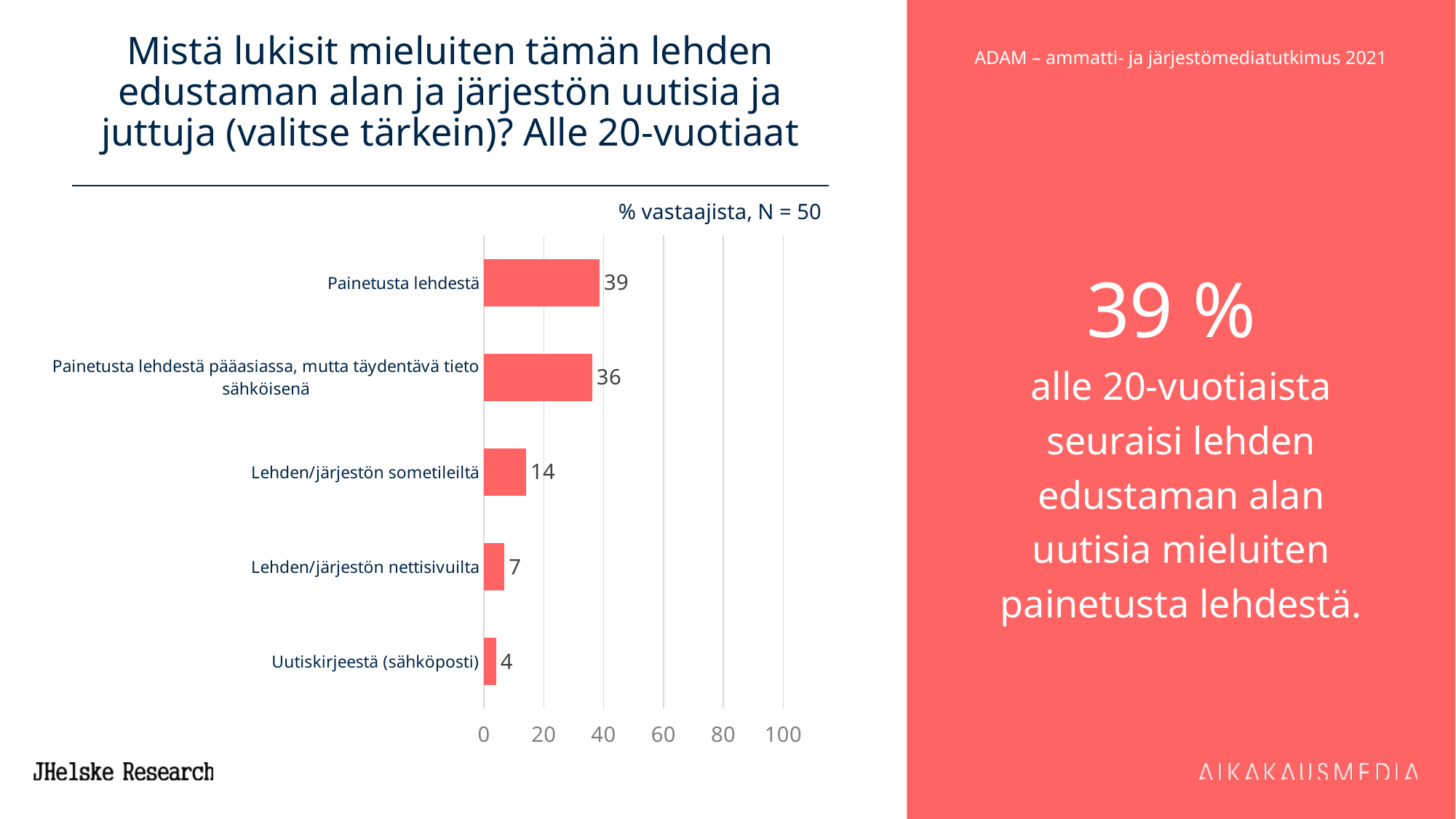
What is the value for "Painetusta lehdestä"? 39 What kind of chart is shown on the slide? bar chart Which category has the lowest value? Uutiskirjeestä (sähköposti) Which is larger: the value for "Lehden/järjestön sometileiltä" or for "Lehden/järjestön nettisivuilta"? Lehden/järjestön sometileiltä What is the value for "Uutiskirjeestä (sähköposti)"? 4 Is the value for "Painetusta lehdestä pääasiassa, mutta täydentävä tieto sähköisenä" greater or less than 40? less What is the difference between the values for "Painetusta lehdestä" and "Painetusta lehdestä pääasiassa, mutta täydentävä tieto sähköisenä"? 3 What is the value for "Lehden/järjestön nettisivuilta"? 7 What is the sample size (N) stated above the chart? N = 50 Which category has the highest value? Painetusta lehdestä What is the value for "Lehden/järjestön sometileiltä"? 14 How many categories are shown in the chart? 5